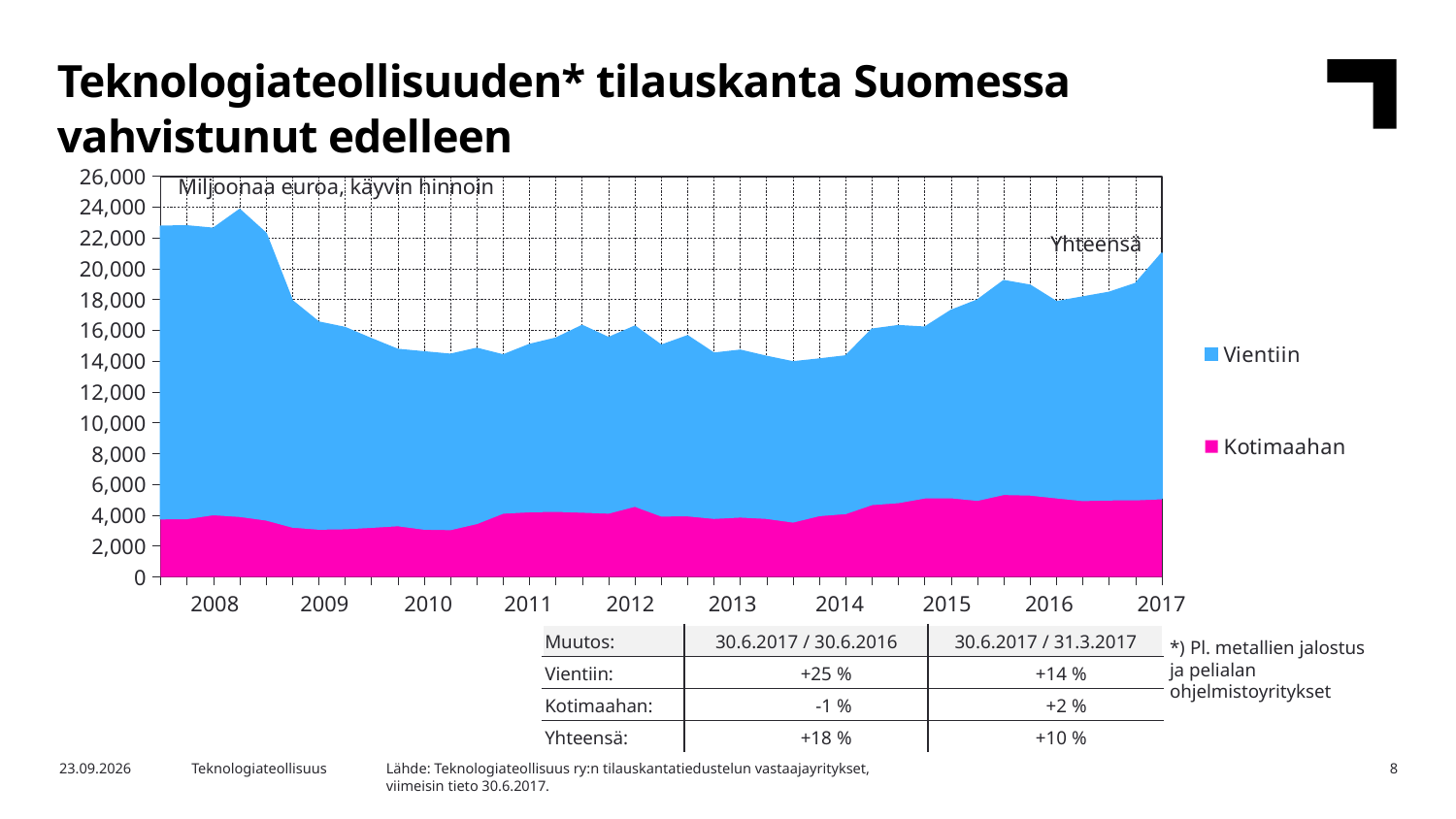
Is the Kotimaahan value in 2010 greater or less than 4,000? less How many series does the chart legend list? 2 Is the total (Yhteensä) value at the start of 2014 greater or less than 16,000? less Does the total order book (Yhteensä) rise or fall from 2014 to 2017? Rise Is the Kotimaahan value in 2016 greater or less than 4,000? greater Does the total order book (Yhteensä) rise or fall from 2008 to 2010? Fall How many years are labelled on the x axis of the chart? 10 Which series is larger in 2017, Vientiin or Kotimaahan? Vientiin What kind of chart is shown on the slide? Area chart What unit label is printed inside the chart area? Miljoonaa euroa, käyvin hinnoin Which two series are listed in the chart legend? Vientiin and Kotimaahan